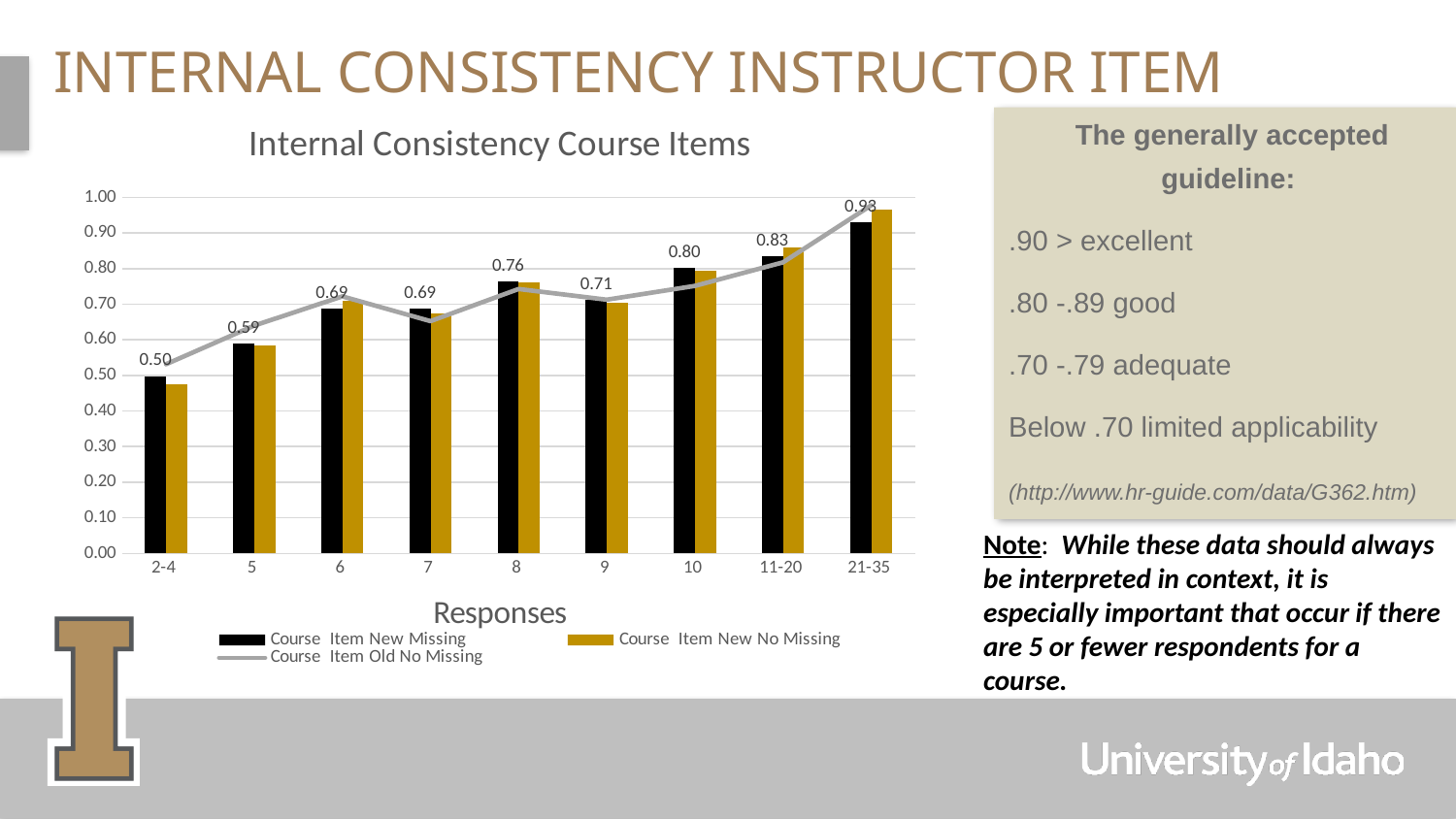
Is the Course Item New No Missing value for the 2-4 responses category greater or less than 0.50? less What kind of chart is shown on the slide? A combined bar and line chart How many responses categories are shown on the x axis? 9 Which responses category has the lowest Course Item New Missing value? 2-4 Do the Course Item New Missing values generally rise or fall as the number of responses increases? rise Which responses category has the highest Course Item New Missing value? 21-35 What is the value of Course Item New Missing for the 2-4 responses category? 0.50 What is the value of Course Item New Missing for the 10 responses category? 0.80 What is the value of Course Item New Missing for the 21-35 responses category? 0.93 How many series does the legend list? 3 What is the difference between the Course Item New Missing values for 21-35 and 2-4 responses? 0.43 Which is larger, the Course Item New Missing value for 8 responses or for 9 responses? 8 responses